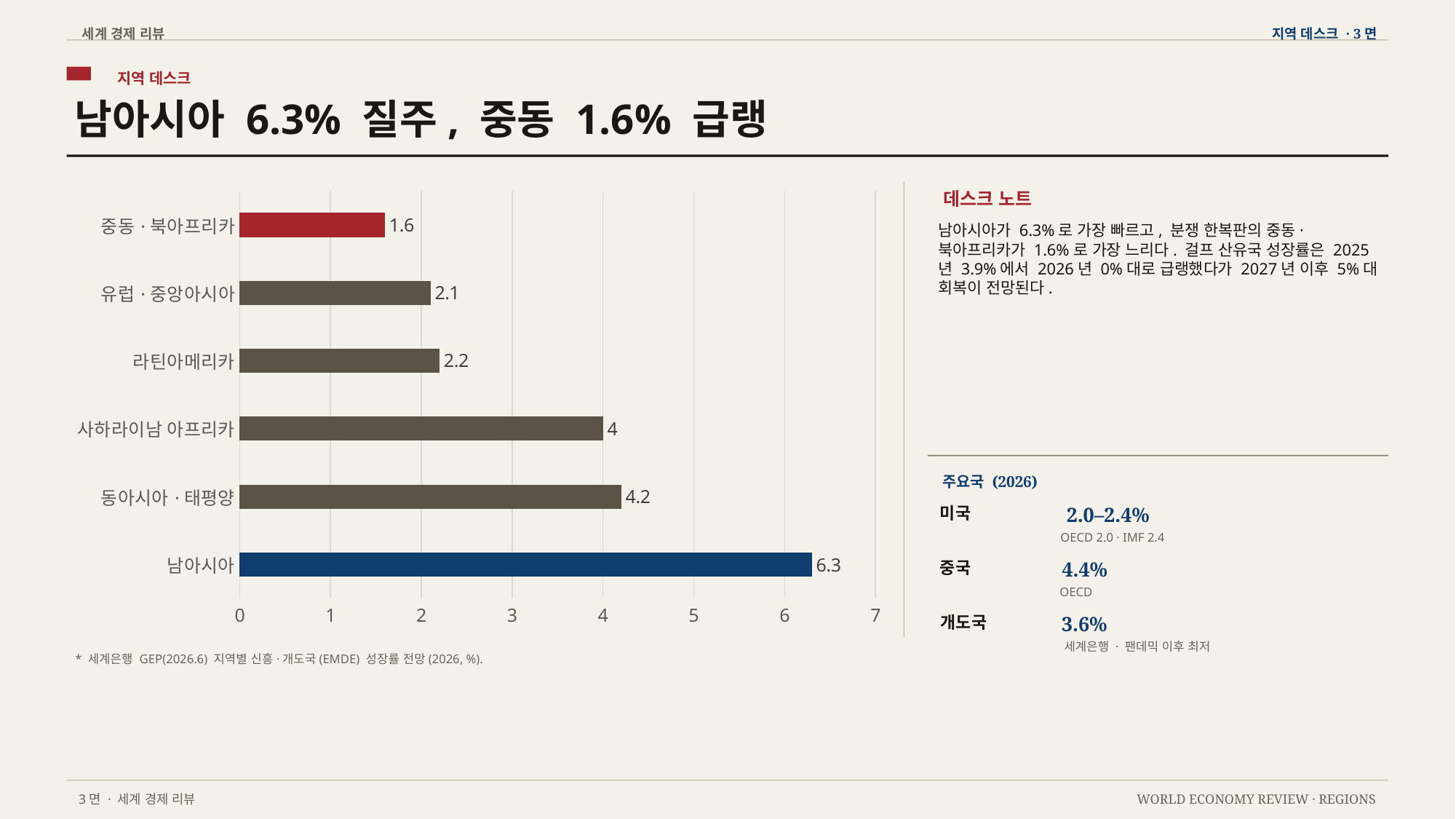
What kind of chart is shown on the slide? bar chart How many regions are shown in the chart? 6 What is the difference between the values for 동아시아·태평양 and 사하라이남 아프리카? 0.2 Which region has the highest value? 남아시아 What is the difference between the values for 남아시아 and 중동·북아프리카? 4.7 What is the value for 중동·북아프리카? 1.6 Which is larger, the value for 라틴아메리카 or the value for 사하라이남 아프리카? 사하라이남 아프리카 What is the value for 유럽·중앙아시아? 2.1 What is the value for 사하라이남 아프리카? 4 What colour is the bar for 남아시아? blue What is the value for 남아시아? 6.3 Which region has the lowest value? 중동·북아프리카